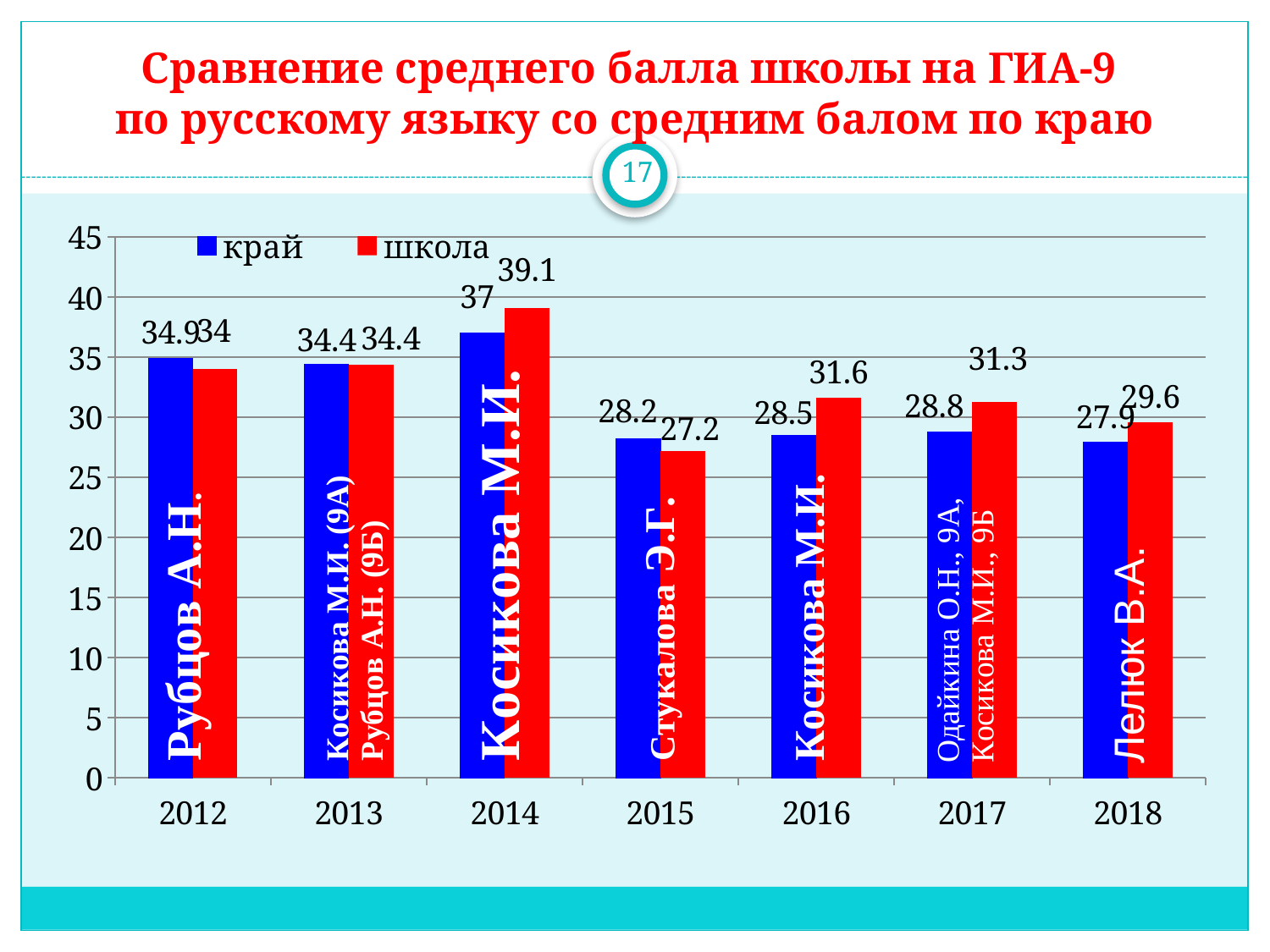
What is the value for край in 2018? 27.9 What is the value for школа in 2014? 39.1 Is the школа value for 2017 greater or less than 30? greater Which is larger in 2015, the край value or the школа value? край What is the difference between the школа and край values in 2014? 2.1 What kind of chart is shown on the slide? bar chart What is the value for школа in 2015? 27.2 How many years are shown on the x axis? 7 How many series does the legend list? 2 In which year is the школа value highest? 2014 What is the value for край in 2016? 28.5 In which year is the край value lowest? 2018